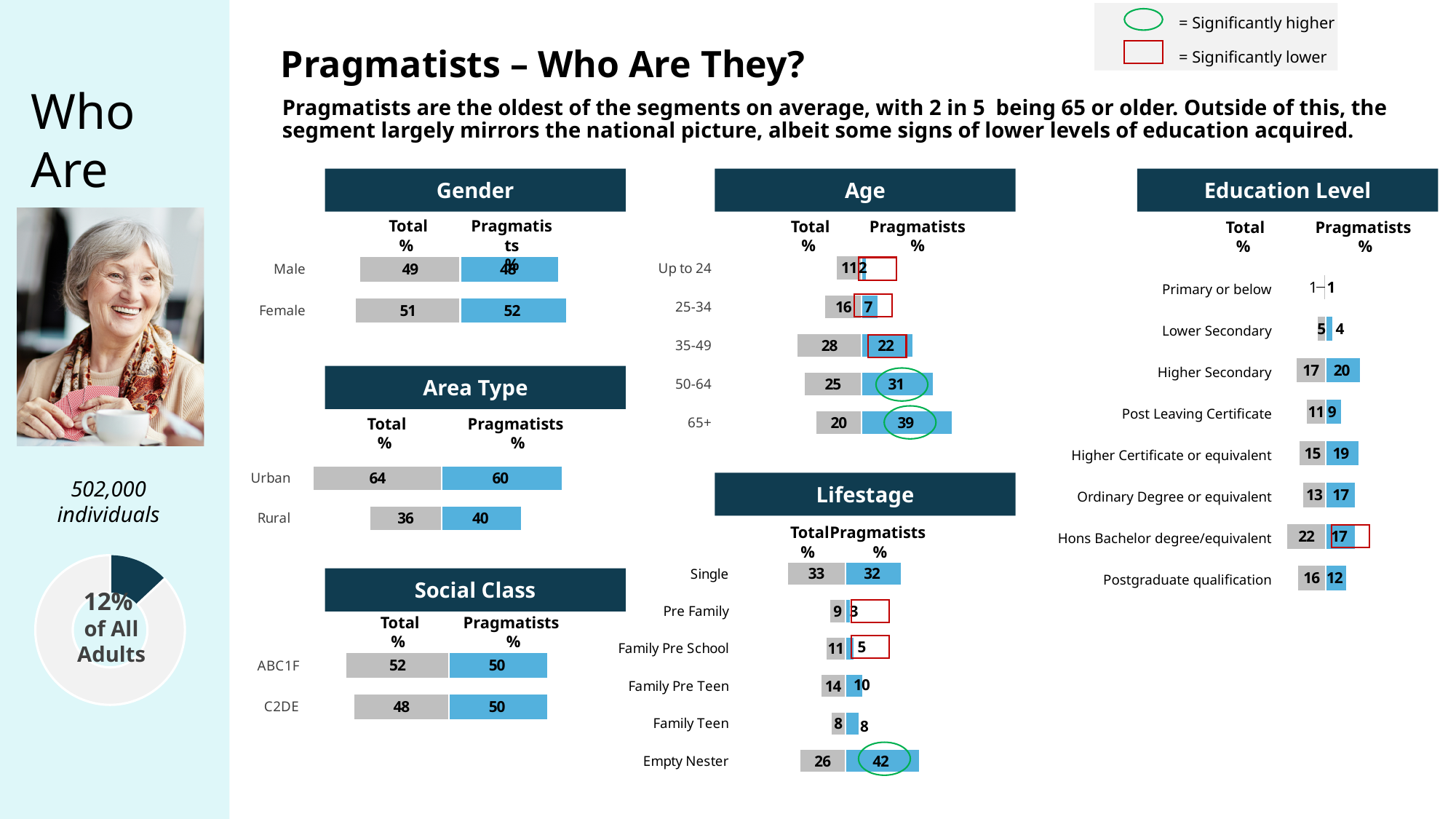
In the Area Type chart, what is the Total % value for Rural? 36 In the Age chart, which age group has the highest Pragmatists % value? 65+ In the Age chart, what is the Pragmatists % value for the 65+ group? 39 In the Social Class chart, what is the Pragmatists % value for C2DE? 50 In the Education Level chart, which education level has the highest Total % value? Hons Bachelor degree/equivalent In the Education Level chart, what is the Pragmatists % value for Hons Bachelor degree/equivalent? 17 How many age groups are shown in the Age chart? 5 In the Age chart, which age group has the lowest Pragmatists % value? Up to 24 What kind of chart is the Gender chart? bar chart In the Lifestage chart, what is the difference between the Pragmatists % and Total % values for Empty Nester? 16 In the Lifestage chart, what is the Pragmatists % value for Empty Nester? 42 In the Area Type chart, which is larger for Urban: the Total % or the Pragmatists % value? Total %